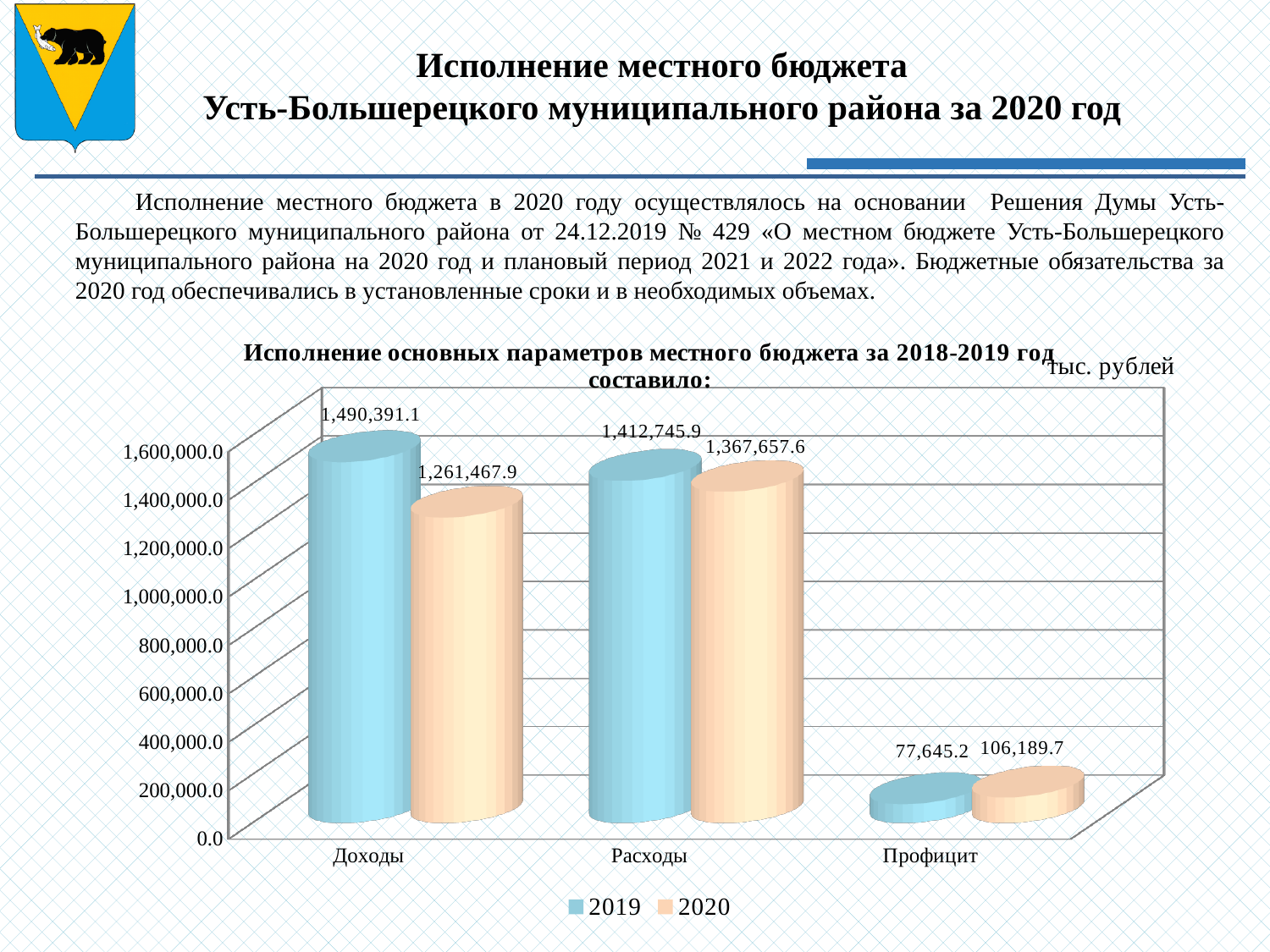
What is the value for Профицит in the 2020 series? 106,189.7 How many categories are shown on the x axis? 3 Which is larger for Профицит: the 2019 value or the 2020 value? 2020 What is the value for Расходы in the 2020 series? 1,367,657.6 What is the difference between the 2019 and 2020 values for Расходы? 45,088.3 What is the value for Профицит in the 2019 series? 77,645.2 Which category has the lowest value in the 2020 series? Профицит What kind of chart is shown on the slide? Bar chart What is the value for Доходы in the 2019 series? 1,490,391.1 Which category has the highest value in the 2019 series? Доходы What is the difference between the 2019 and 2020 values for Доходы? 228,923.2 How many series does the legend list? 2